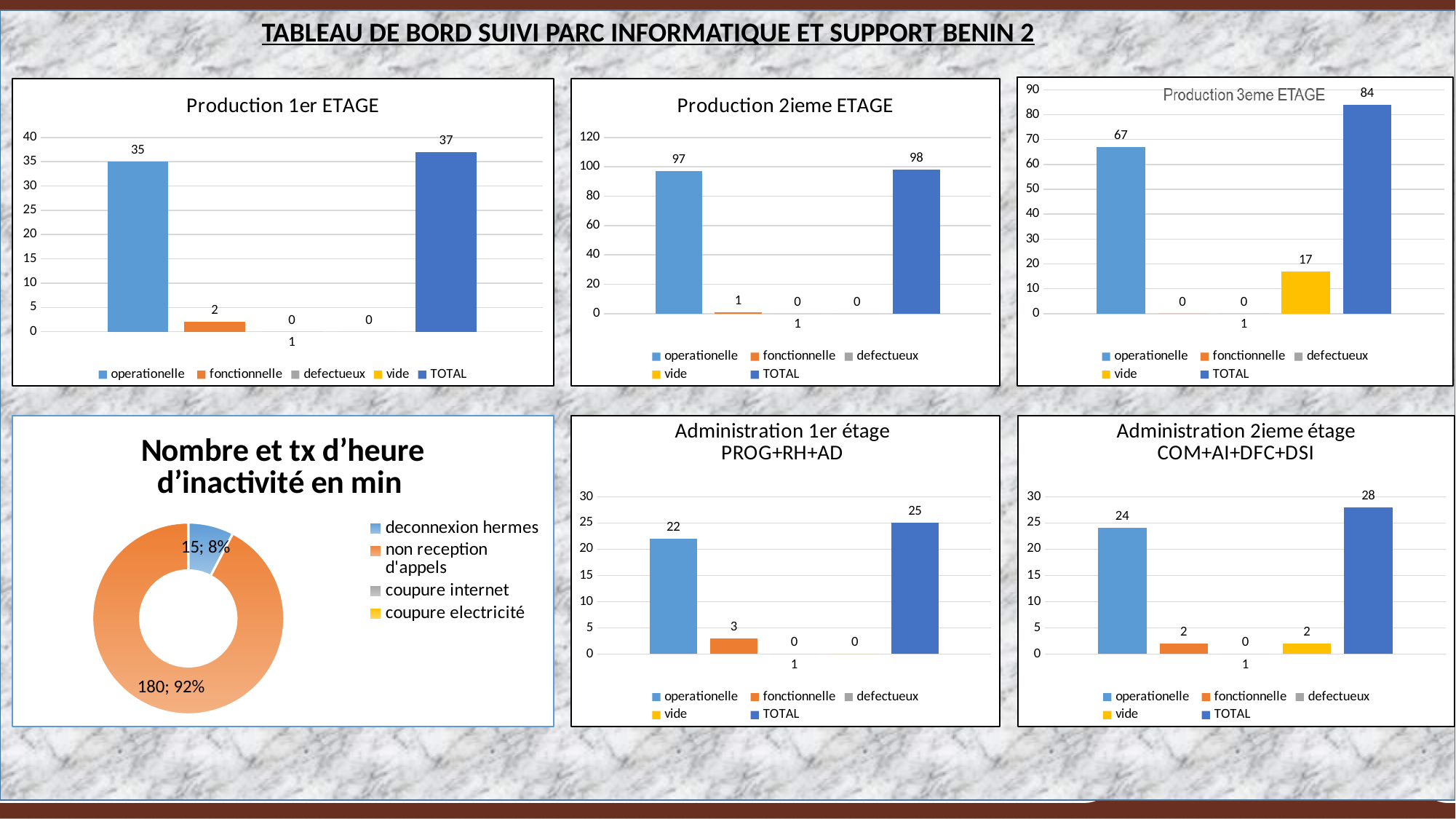
In the 'Production 3eme ETAGE' chart, which series has the highest value? TOTAL In the 'Administration 2ieme étage COM+AI+DFC+DSI' chart, what is the value for TOTAL? 28 In the 'Production 2ieme ETAGE' chart, what is the difference between TOTAL and operationelle? 1 What kind of chart is 'Nombre et tx d'heure d'inactivité en min'? Doughnut chart In the 'Production 2ieme ETAGE' chart, what is the value for TOTAL? 98 In the 'Production 3eme ETAGE' chart, what is the value for vide? 17 Which is larger: operationelle in 'Administration 1er étage PROG+RH+AD' or operationelle in 'Administration 2ieme étage COM+AI+DFC+DSI'? Administration 2ieme étage COM+AI+DFC+DSI In the 'Nombre et tx d'heure d'inactivité en min' chart, what share does 'non reception d'appels' have? 92% How many series does the legend of the 'Production 1er ETAGE' chart list? 5 In the 'Nombre et tx d'heure d'inactivité en min' chart, what is the value for 'deconnexion hermes'? 15 In the 'Production 1er ETAGE' chart, what is the value for operationelle? 35 In the 'Administration 1er étage PROG+RH+AD' chart, what is the value for fonctionnelle? 3